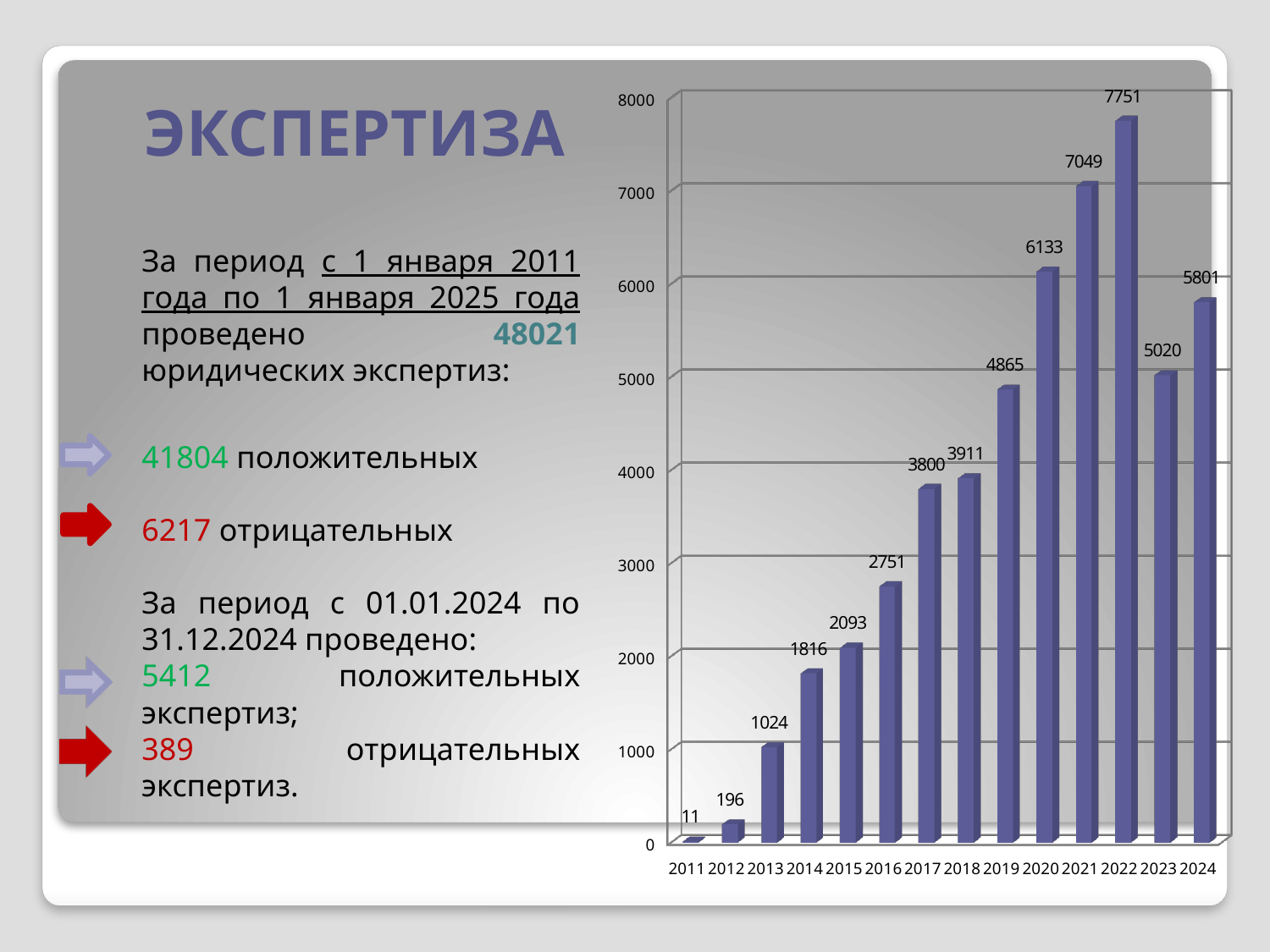
What is the value for 2024? 5801 How many years are shown on the x axis? 14 Do the values rise or fall from 2011 to 2022? rise What is the difference between the values for 2022 and 2021? 702 Is the value for 2019 greater or less than 5000? less Which year has the highest value? 2022 What is the value for 2022? 7751 Which year has the lowest value? 2011 What is the difference between the values for 2024 and 2023? 781 What is the value for 2013? 1024 What kind of chart is shown? bar chart Which is larger, the value for 2020 or the value for 2024? 2020